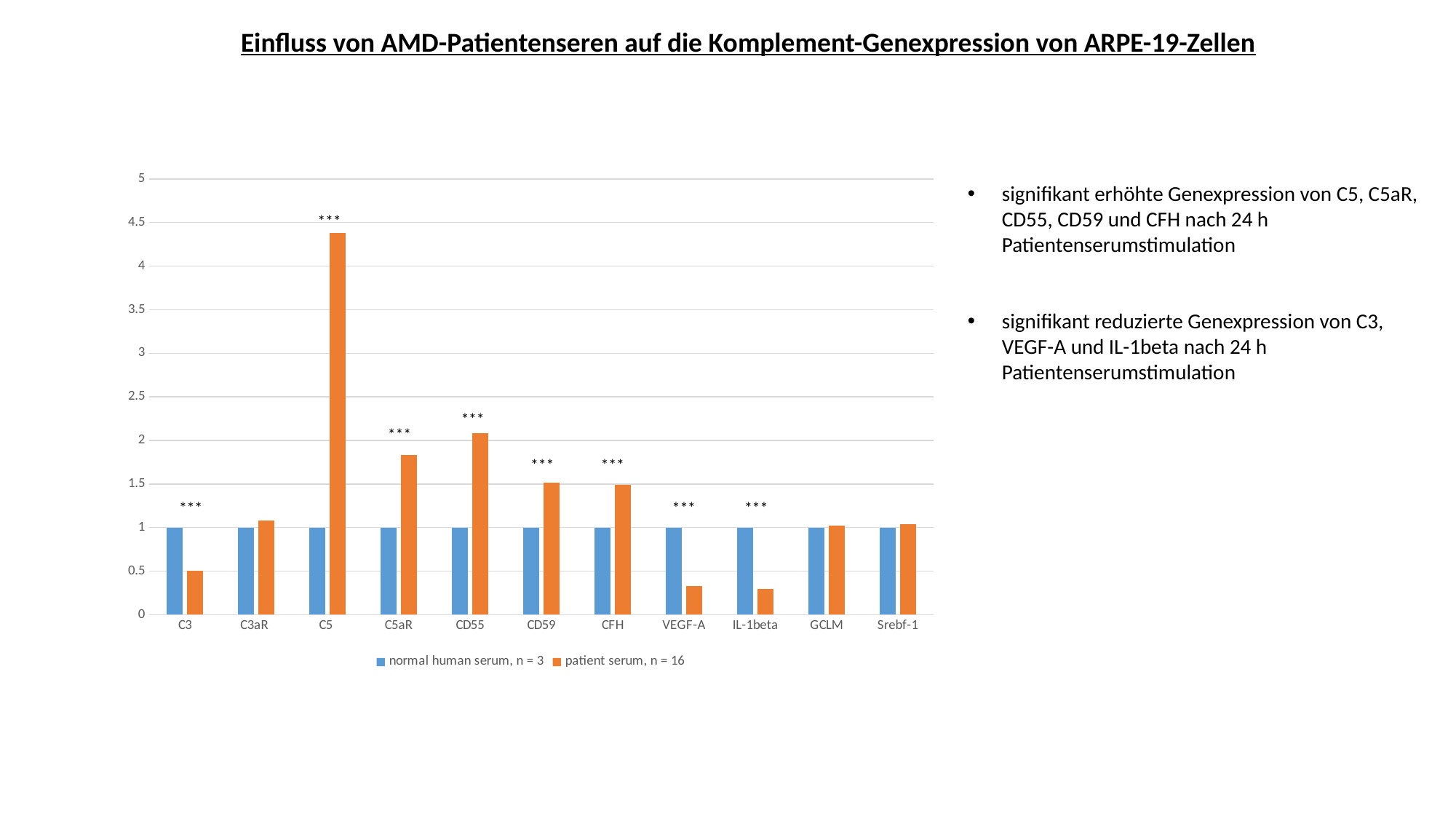
Is the value for patient serum, n = 16 for C5 greater or less than 4? greater Which is larger for C3: the value for normal human serum, n = 3 or the value for patient serum, n = 16? normal human serum, n = 3 What is the value for normal human serum, n = 3 for C5? 1 Is the value for patient serum, n = 16 for VEGF-A greater or less than 0.5? less Which is larger for patient serum, n = 16: the value for C5aR or the value for CD59? C5aR What kind of chart is shown on the slide? bar chart Is the value for patient serum, n = 16 for CD55 greater or less than 2? greater What is the title of the slide containing the chart? Einfluss von AMD-Patientenseren auf die Komplement-Genexpression von ARPE-19-Zellen Which gene has the highest value for patient serum, n = 16? C5 How many series does the chart legend list? 2 Which gene has the lowest value for patient serum, n = 16? IL-1beta How many gene categories are shown on the x axis of the chart? 11